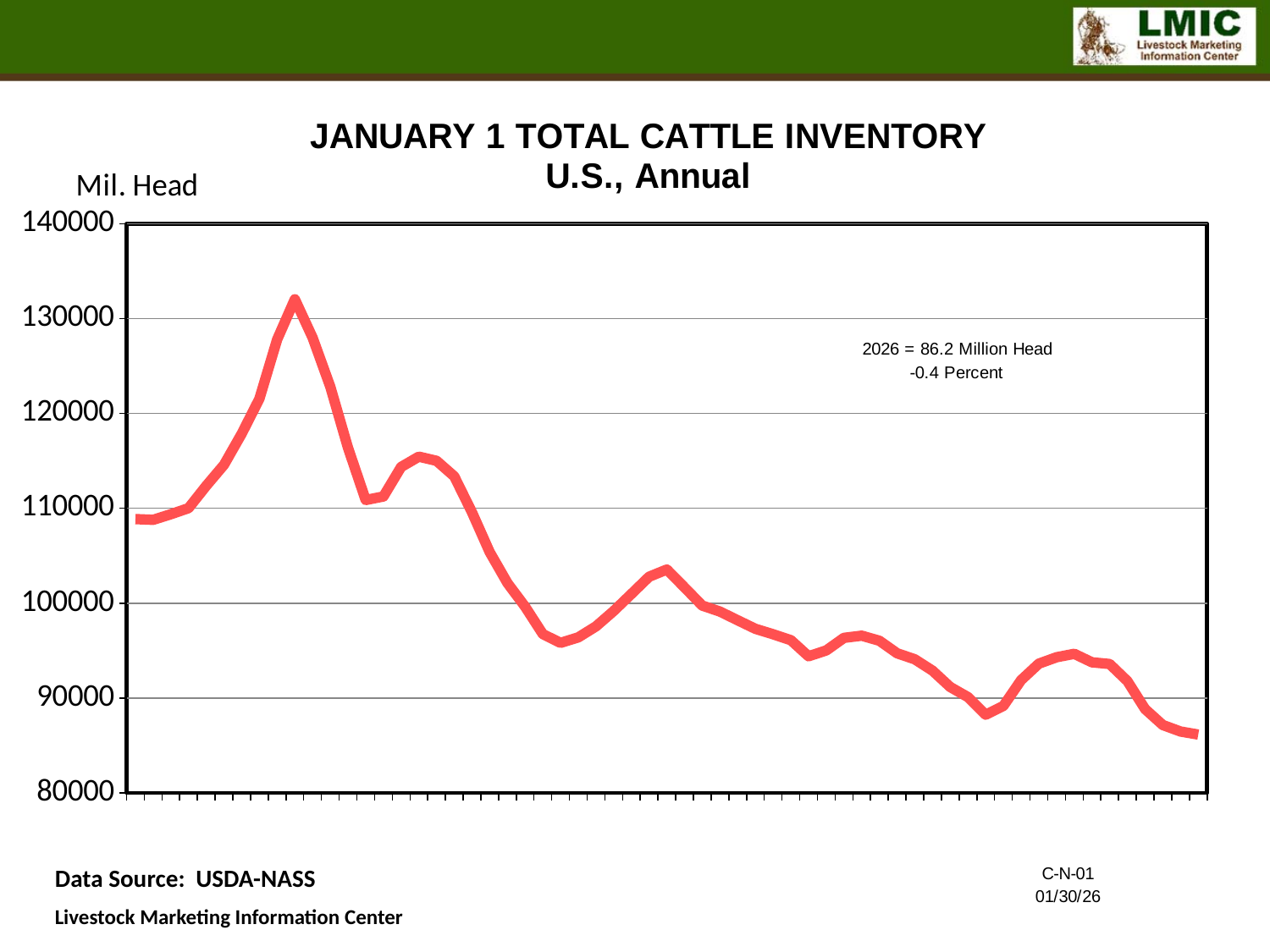
How many lines are plotted on the chart? 1 What is the title of the chart? JANUARY 1 TOTAL CATTLE INVENTORY U.S., Annual According to the annotation on the chart, what is the January 1 total cattle inventory for 2026? 86.2 Million Head What is the data source cited on the slide? USDA-NASS What unit label is shown above the vertical axis? Mil. Head What kind of chart is shown on the slide? line chart Overall, does the cattle inventory rise or fall from the left of the chart to the right? fall Is the last point on the right end of the line greater or less than 90000? less According to the annotation on the chart, what is the percent change for 2026? -0.4 Percent Is the lowest point on the line greater or less than 80000? greater Is the highest point on the line greater or less than 130000? greater